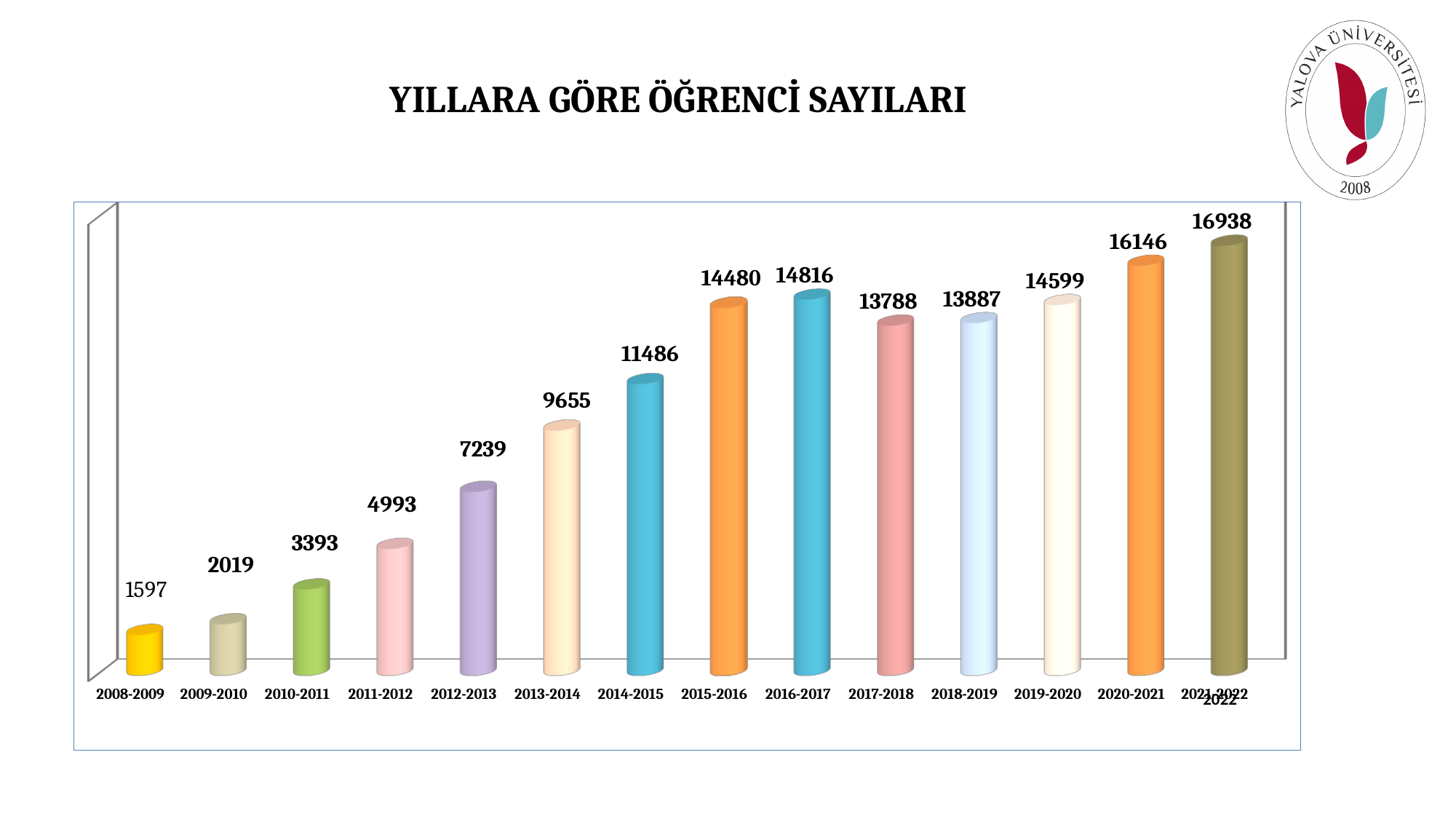
Do the values generally rise or fall from 2008-2009 to 2015-2016? rise Which year has the lowest value? 2008-2009 What is the value for 2008-2009? 1597 What is the difference between the values for 2021-2022 and 2020-2021? 792 Which is larger, the value for 2016-2017 or the value for 2017-2018? 2016-2017 What is the difference between the values for 2015-2016 and 2014-2015? 2994 What is the value for 2019-2020? 14599 What kind of chart is shown on the slide? bar chart What is the value for 2016-2017? 14816 Which year has the highest value? 2021-2022 What is the title of the chart? YILLARA GÖRE ÖĞRENCİ SAYILARI How many years are shown on the x axis? 14